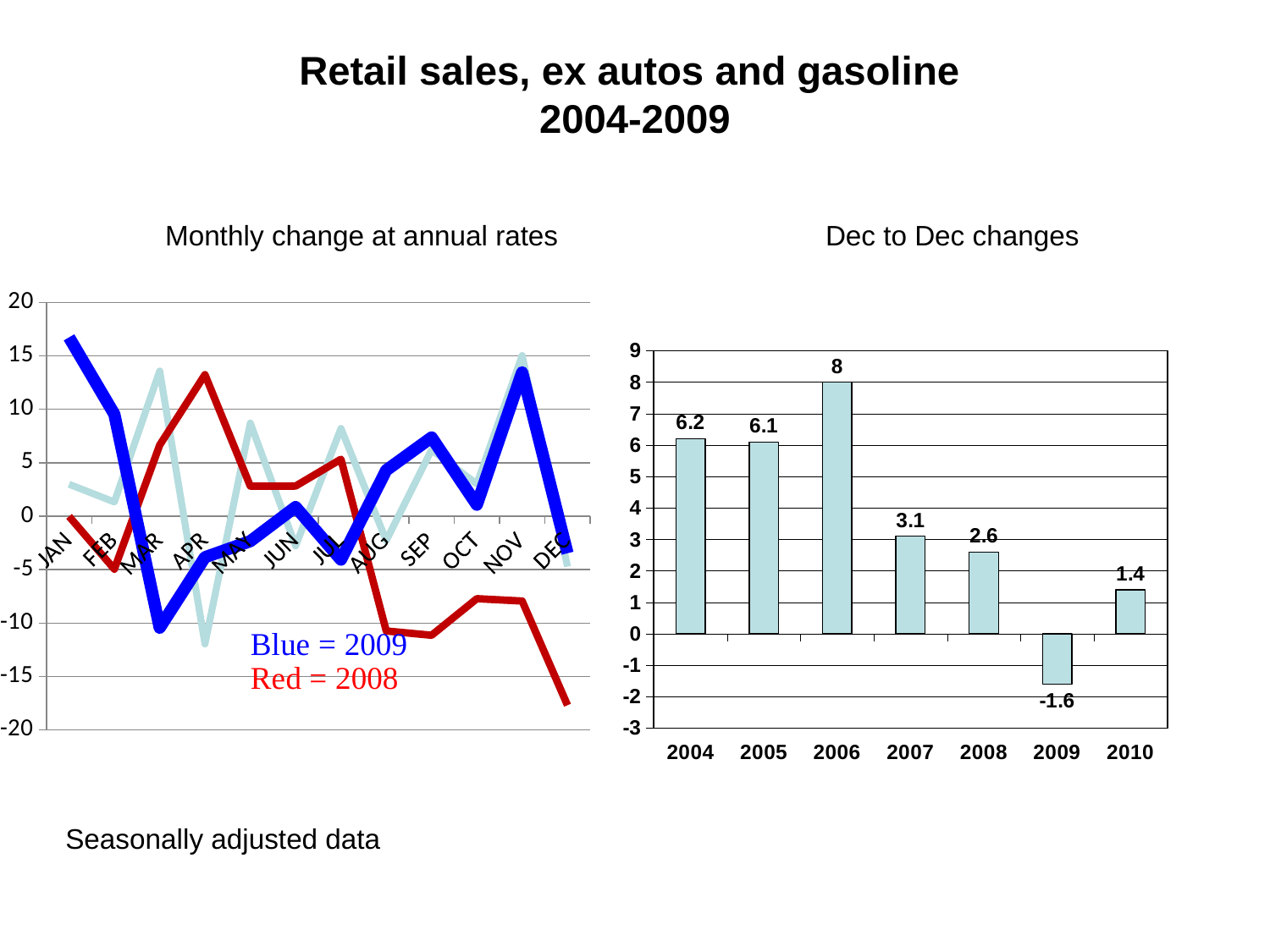
In the 'Monthly change at annual rates' chart, is the red (2008) value for DEC greater or less than -15? less In the 'Dec to Dec changes' chart, what is the value for 2010? 1.4 In the 'Dec to Dec changes' chart, which is larger, the value for 2008 or the value for 2010? 2008 In the 'Dec to Dec changes' chart, what is the value for 2006? 8 In the 'Dec to Dec changes' chart, what is the value for 2009? -1.6 In the 'Dec to Dec changes' chart, which year has the highest value? 2006 What kind of chart is the 'Dec to Dec changes' chart? bar chart In the 'Monthly change at annual rates' chart, is the blue (2009) value for JAN greater or less than 15? greater In the 'Dec to Dec changes' chart, what is the difference between the values for 2004 and 2007? 3.1 In the 'Dec to Dec changes' chart, which year has the lowest value? 2009 What kind of chart is the 'Monthly change at annual rates' chart? line chart How many years are shown in the 'Dec to Dec changes' chart? 7